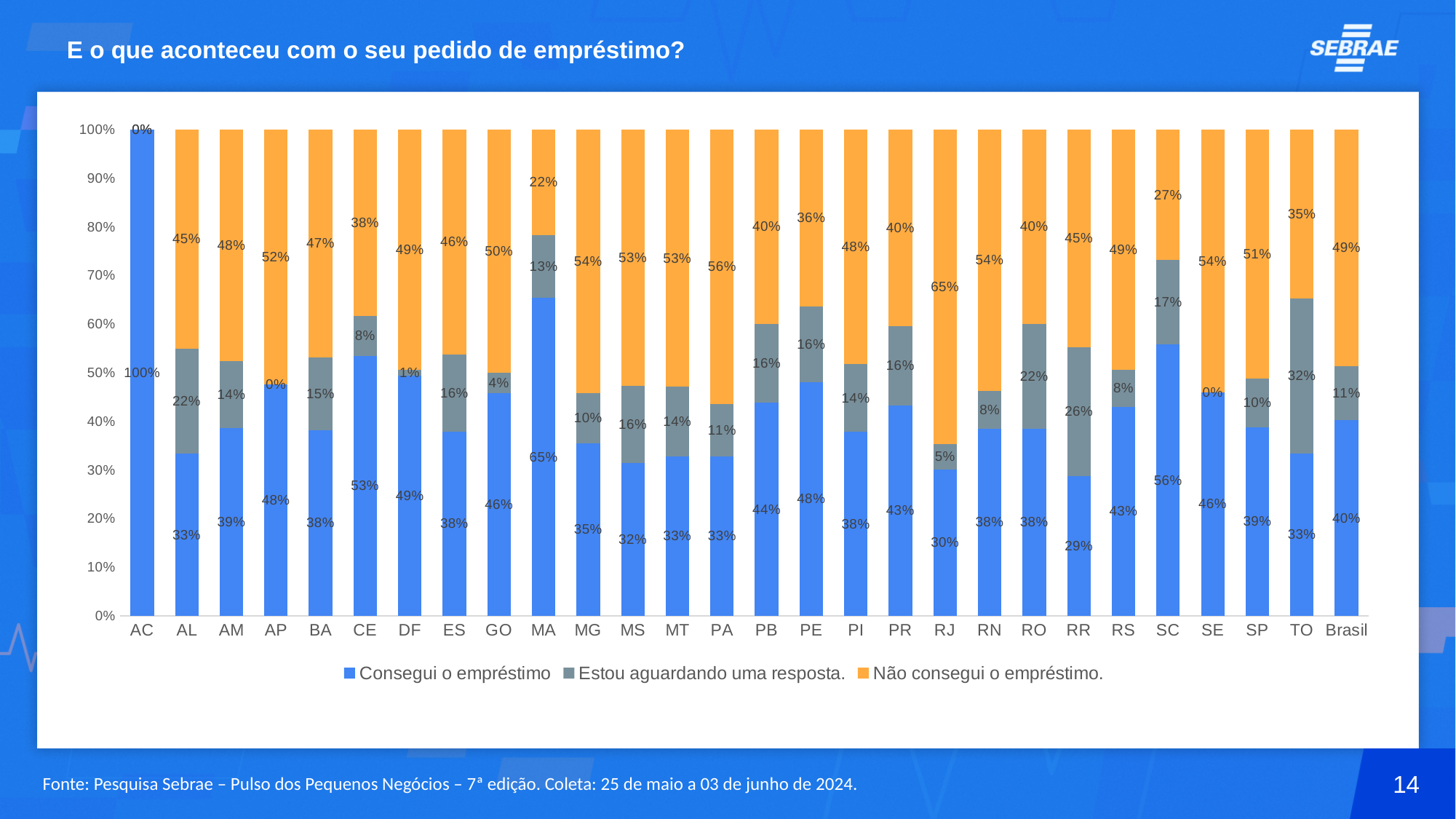
Which state has the highest value for "Não consegui o empréstimo."? RJ Which state has the lowest value for "Consegui o empréstimo"? RR What kind of chart is shown on the slide? Stacked bar chart What is the value for "Não consegui o empréstimo." in RJ? 65% How many series does the legend list? 3 Which colour represents "Estou aguardando uma resposta." in the chart? Gray What is the difference between the "Consegui o empréstimo" values for SC and RJ? 26% What share of respondents in TO are "Estou aguardando uma resposta."? 32% How many categories are shown on the x axis? 28 Which is larger: the "Não consegui o empréstimo." value for PA or for PE? PA Excluding AC, which state has the highest value for "Consegui o empréstimo"? MA What percentage of respondents in Brasil answered "Consegui o empréstimo"? 40%